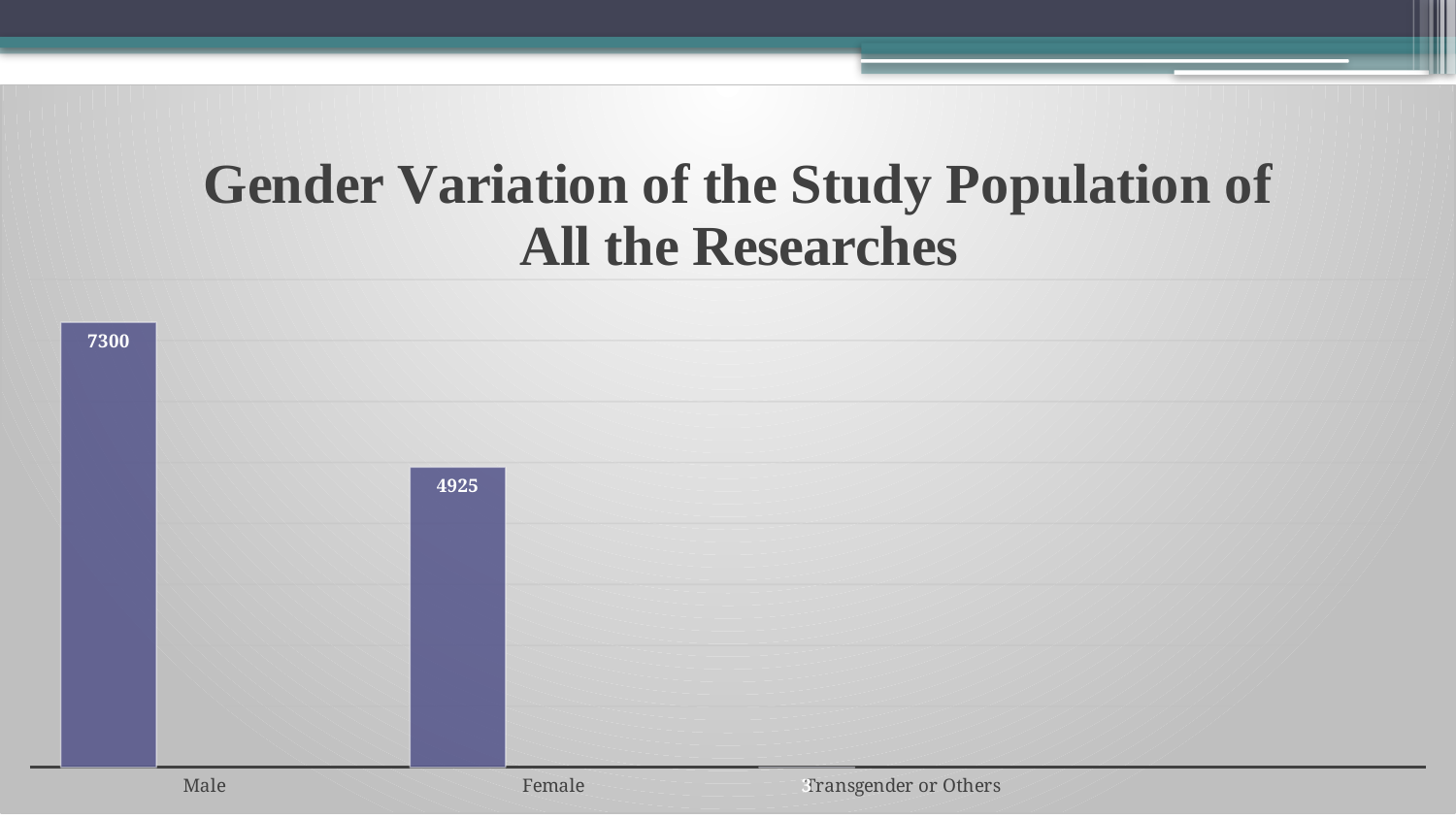
Which is larger, the value for Male or the value for Female? Male What is the label of the third category on the x axis? Transgender or Others What is the value for Female? 4925 What kind of chart is shown on the slide? Bar chart Which category has the lowest value? Transgender or Others What is the title of the chart? Gender Variation of the Study Population of All the Researches What is the value for Male? 7300 Do the values rise or fall from left to right across the categories? Fall What is the difference between the Male and Female values? 2375 Which category has the highest value? Male How many categories are shown on the x axis? 3 Which is larger, the value for Female or the value for Transgender or Others? Female